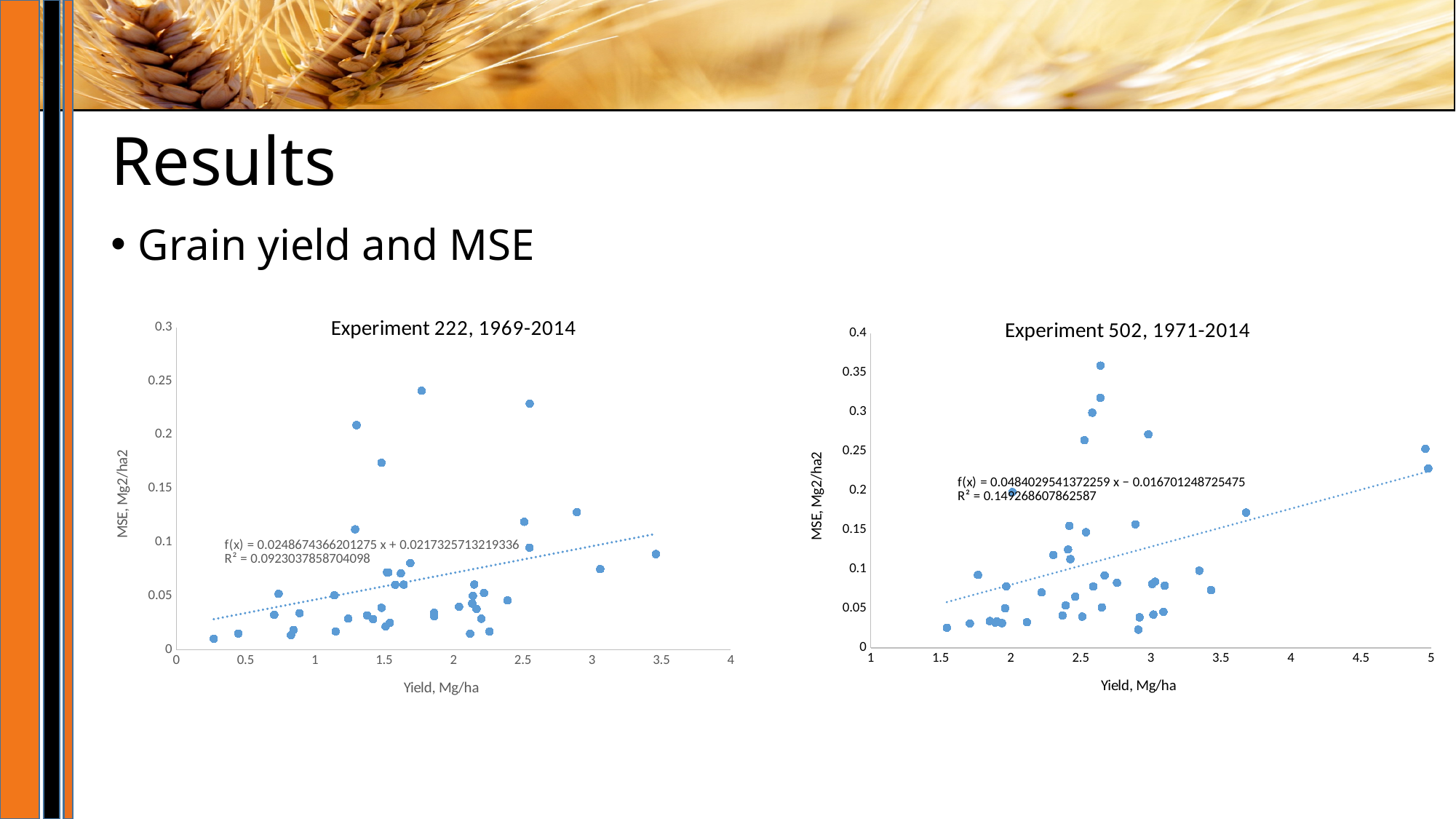
What kind of chart is the Experiment 222, 1969-2014 chart? scatter chart What is the R² value printed on the Experiment 502, 1971-2014 chart? 0.149268607862587 Which chart's trendline has the larger slope, Experiment 222 or Experiment 502? Experiment 502 In the Experiment 222, 1969-2014 chart, does the fitted trendline rise or fall as yield increases? rises In the Experiment 502, 1971-2014 chart, does the fitted trendline rise or fall as yield increases? rises What is the x-axis label on the Experiment 222, 1969-2014 chart? Yield, Mg/ha In the Experiment 502, 1971-2014 chart, is the highest MSE value plotted greater or less than 0.35? greater What kind of chart is the Experiment 502, 1971-2014 chart? scatter chart Which chart shows the higher R² value, Experiment 222 or Experiment 502? Experiment 502 What is the y-axis label on the Experiment 502, 1971-2014 chart? MSE, Mg2/ha2 What is the R² value printed on the Experiment 222, 1969-2014 chart? 0.0923037858704098 In the Experiment 222, 1969-2014 chart, is the highest MSE value plotted greater or less than 0.25? less